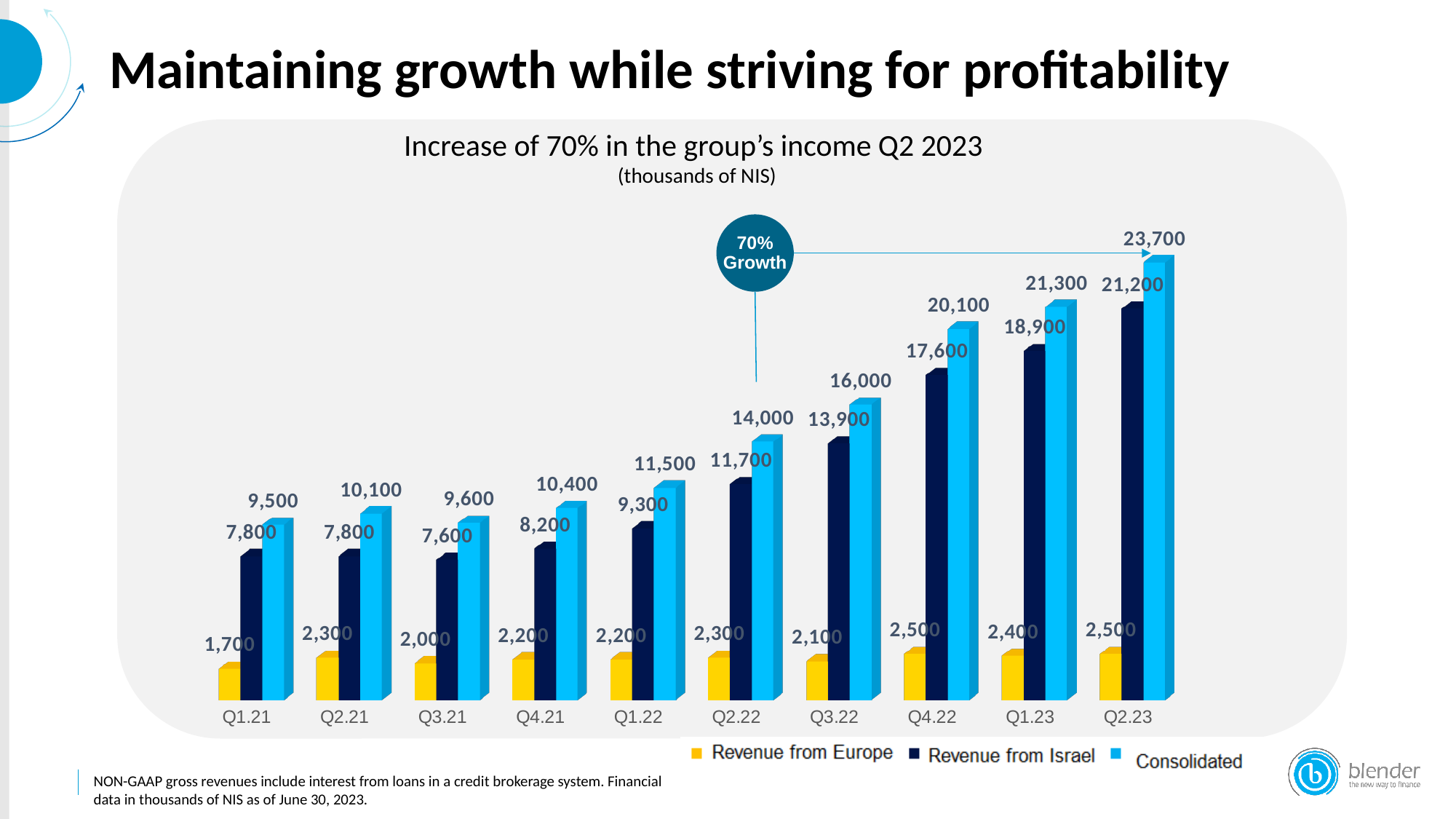
Which quarter has the highest Consolidated value? Q2.23 Which is larger, Revenue from Israel in Q1.23 or Revenue from Israel in Q4.22? Q1.23 What is the difference between the Consolidated values for Q2.23 and Q2.22? 9,700 How many series does the legend list? 3 What is the Consolidated value for Q2.23? 23,700 Does the Consolidated series generally rise or fall from Q1.21 to Q2.23? Rise Which quarter has the lowest Revenue from Israel value? Q3.21 What is the Revenue from Europe value for Q1.21? 1,700 What is the Revenue from Israel value for Q4.22? 17,600 What kind of chart is shown on the slide? Bar chart What growth percentage is shown in the circle callout on the chart? 70% Growth How many quarters are shown on the x axis? 10